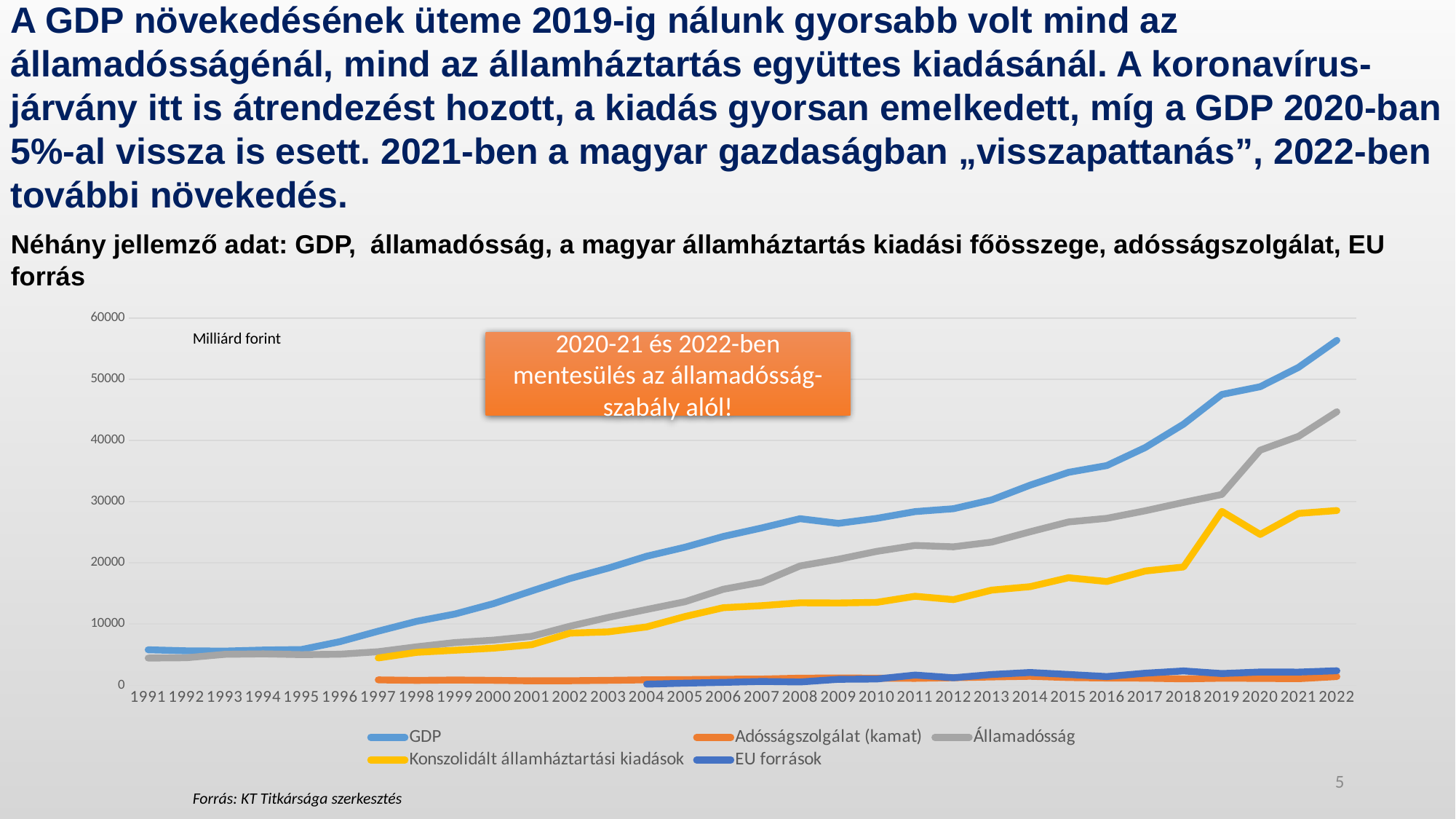
Is the value of Konszolidált államháztartási kiadások in 2022 greater or less than 30000? less In 2022, which is larger: GDP or Államadósság? GDP What unit is stated in the label at the top left of the chart? Milliárd forint How many years are shown on the x axis? 32 In 2022, which is larger: Államadósság or Konszolidált államháztartási kiadások? Államadósság Is the value of GDP in 2022 greater or less than 50000? greater Does the GDP line rise or fall overall from 1991 to 2022? rise Is the value of GDP in 2008 greater or less than 20000? greater How many series does the legend list? 5 What kind of chart is shown on the slide? line chart Which series has the highest value in 2022? GDP